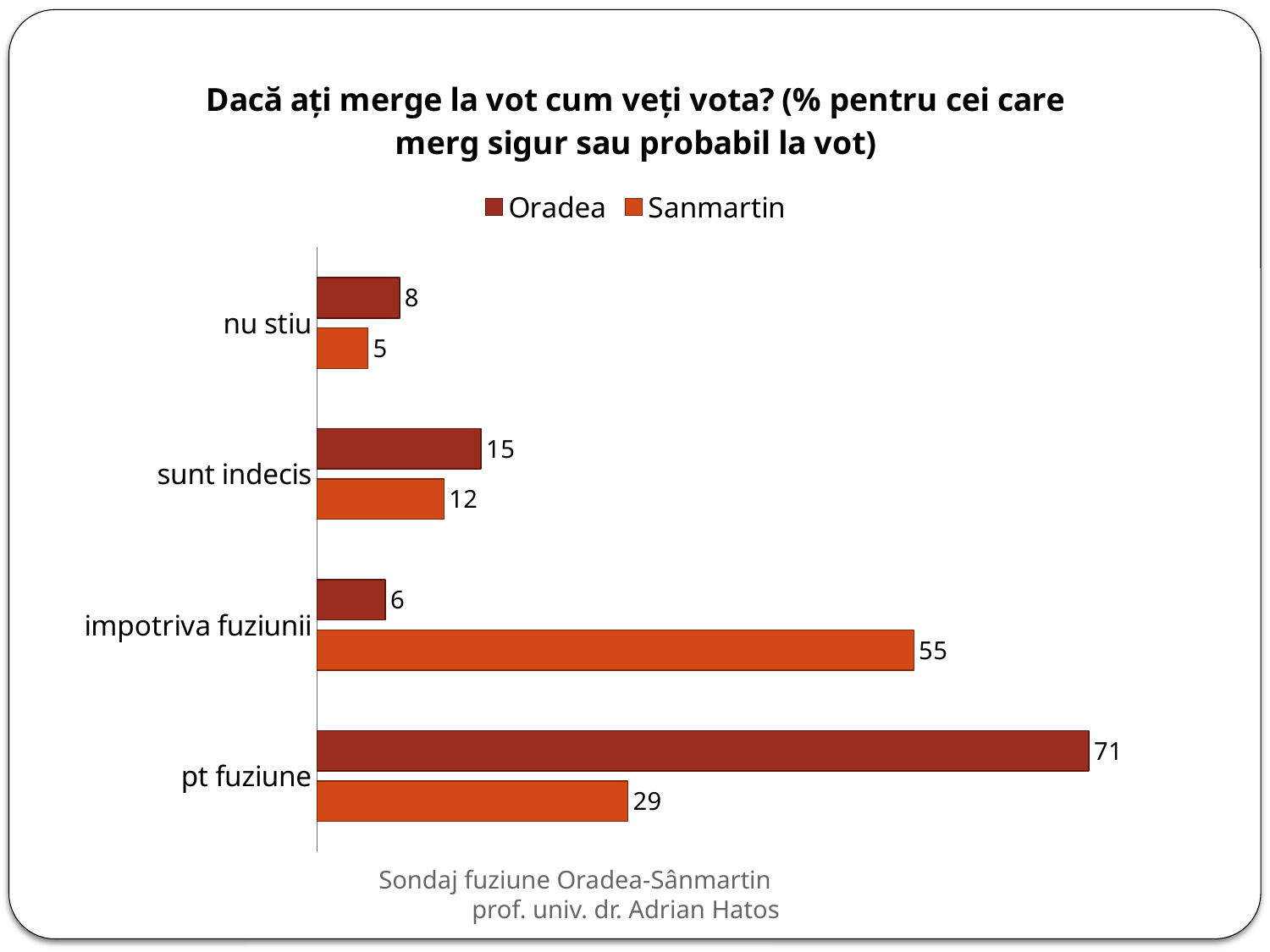
What is the value for Sanmartin in the 'impotriva fuziunii' category? 55 What is the value for Sanmartin in the 'nu stiu' category? 5 How many series does the legend list? 2 Which is larger for 'impotriva fuziunii': the Oradea value or the Sanmartin value? Sanmartin Which series is shown in dark red in the legend? Oradea How many categories are shown on the chart? 4 What is the value for Oradea in the 'sunt indecis' category? 15 Which category has the highest value for Oradea? pt fuziune What is the difference between the Oradea and Sanmartin values for 'pt fuziune'? 42 Which category has the lowest value for Sanmartin? nu stiu What is the value for Oradea in the 'pt fuziune' category? 71 What kind of chart is shown on the slide? Bar chart